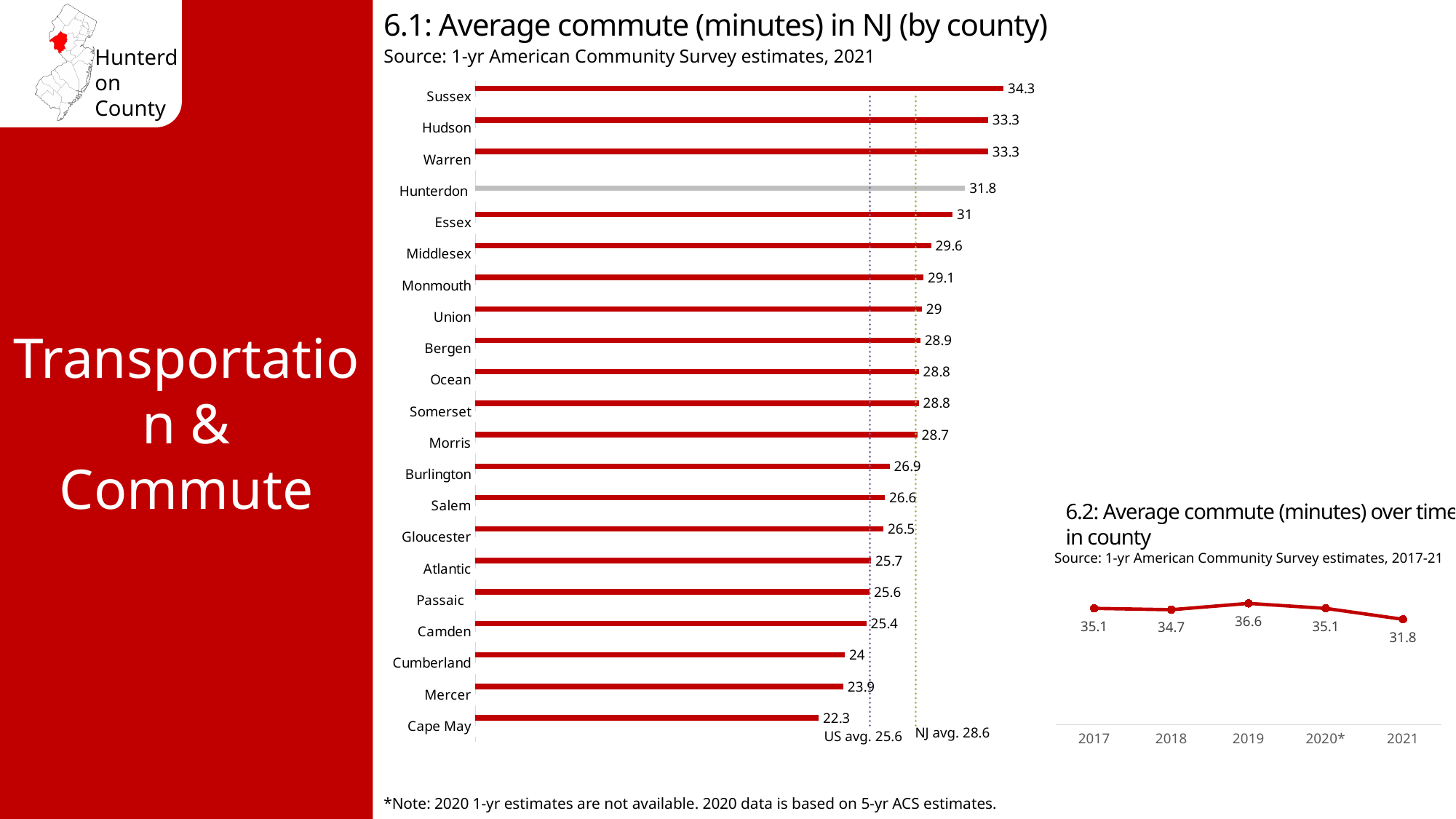
In chart 6.1, what value is shown for the NJ average reference line? 28.6 In chart 6.1 (Average commute in NJ by county), what is the average commute for Hunterdon? 31.8 In chart 6.1, which county has the highest average commute? Sussex In chart 6.1, what is the difference between the average commute for Sussex and Cape May? 12 In chart 6.2, how many data points are plotted? 5 In chart 6.1, how many counties are shown? 21 In chart 6.1, which county has the lowest average commute? Cape May In chart 6.2 (Average commute over time in county), what is the value for 2019? 36.6 In chart 6.2, what is the difference between the 2020* value and the 2021 value? 3.3 In chart 6.1, which has a longer average commute, Essex or Middlesex? Essex In chart 6.2, which year has the lowest average commute? 2021 What kind of chart is chart 6.1? Bar chart